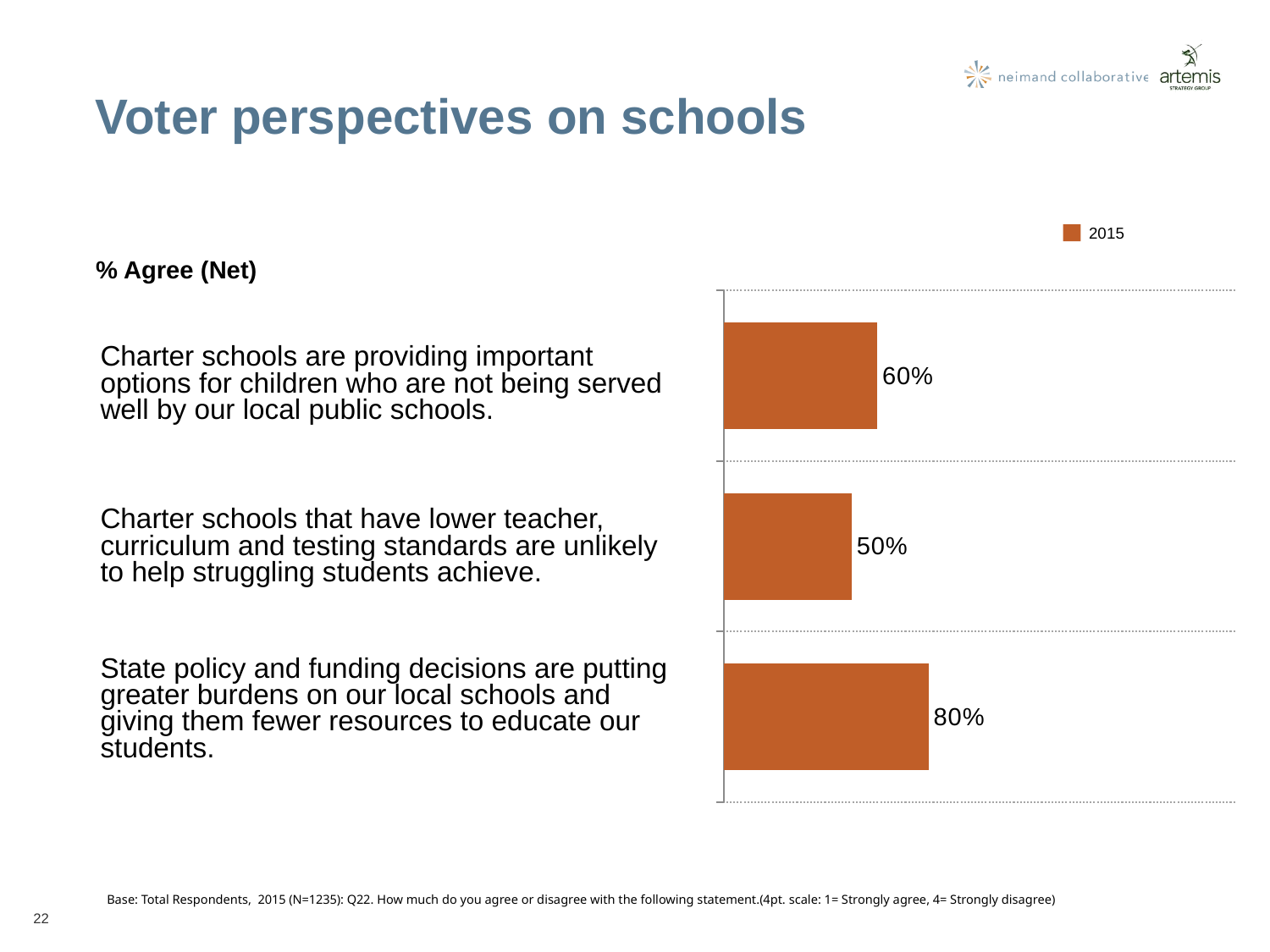
How many statements are shown in the chart? 3 What is the difference in net agreement between the two charter school statements? 10 percentage points What percentage of voters agree that state policy and funding decisions are putting greater burdens on local schools? 80% Which statement has the highest net agreement? State policy and funding decisions are putting greater burdens on our local schools and giving them fewer resources to educate our students. What percentage of voters agree that charter schools are providing important options for children who are not being served well by local public schools? 60% Which has higher net agreement: the statement about charter schools providing important options, or the statement about charter schools with lower standards? Charter schools are providing important options What type of chart is shown on the slide? Bar chart What percentage of voters agree that charter schools with lower teacher, curriculum and testing standards are unlikely to help struggling students achieve? 50% What is the difference in net agreement between the state policy and funding statement and the charter schools providing important options statement? 20 percentage points Which statement has the lowest net agreement? Charter schools that have lower teacher, curriculum and testing standards are unlikely to help struggling students achieve. What year does the legend indicate the data is from? 2015 How many series does the legend list? 1